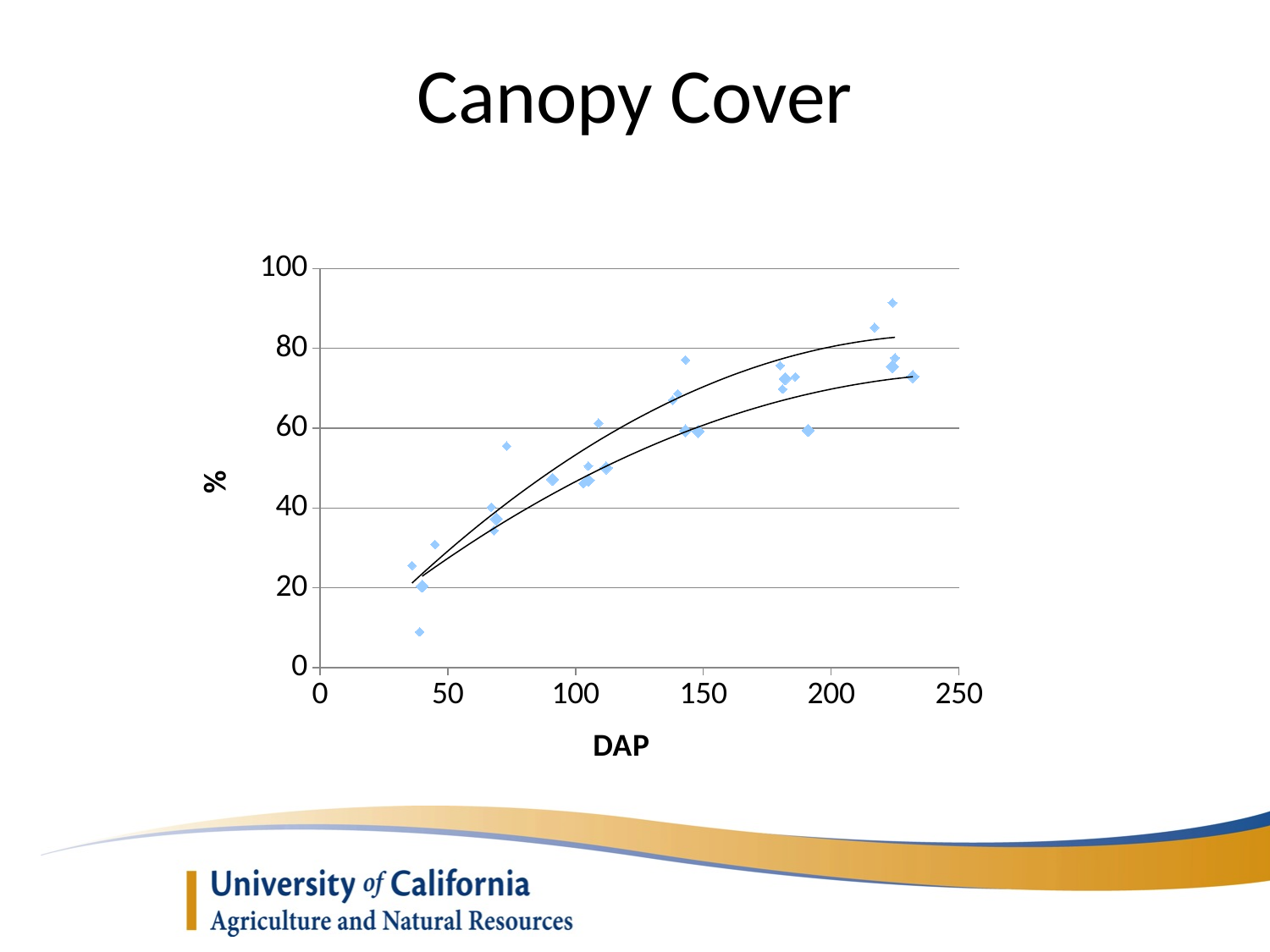
Do the plotted canopy cover values generally rise or fall as DAP increases? rise What is the title of the chart? Canopy Cover Is the plotted point near DAP 73 greater or less than 40%? greater How many fitted trend lines are drawn on the chart? 2 Is the lowest plotted point (near DAP 40) greater or less than 20%? less What kind of chart is shown on the slide? scatter chart What is the maximum value shown on the y axis? 100 What is the label on the x axis of the chart? DAP Is the plotted point near DAP 73 greater or less than 60%? less